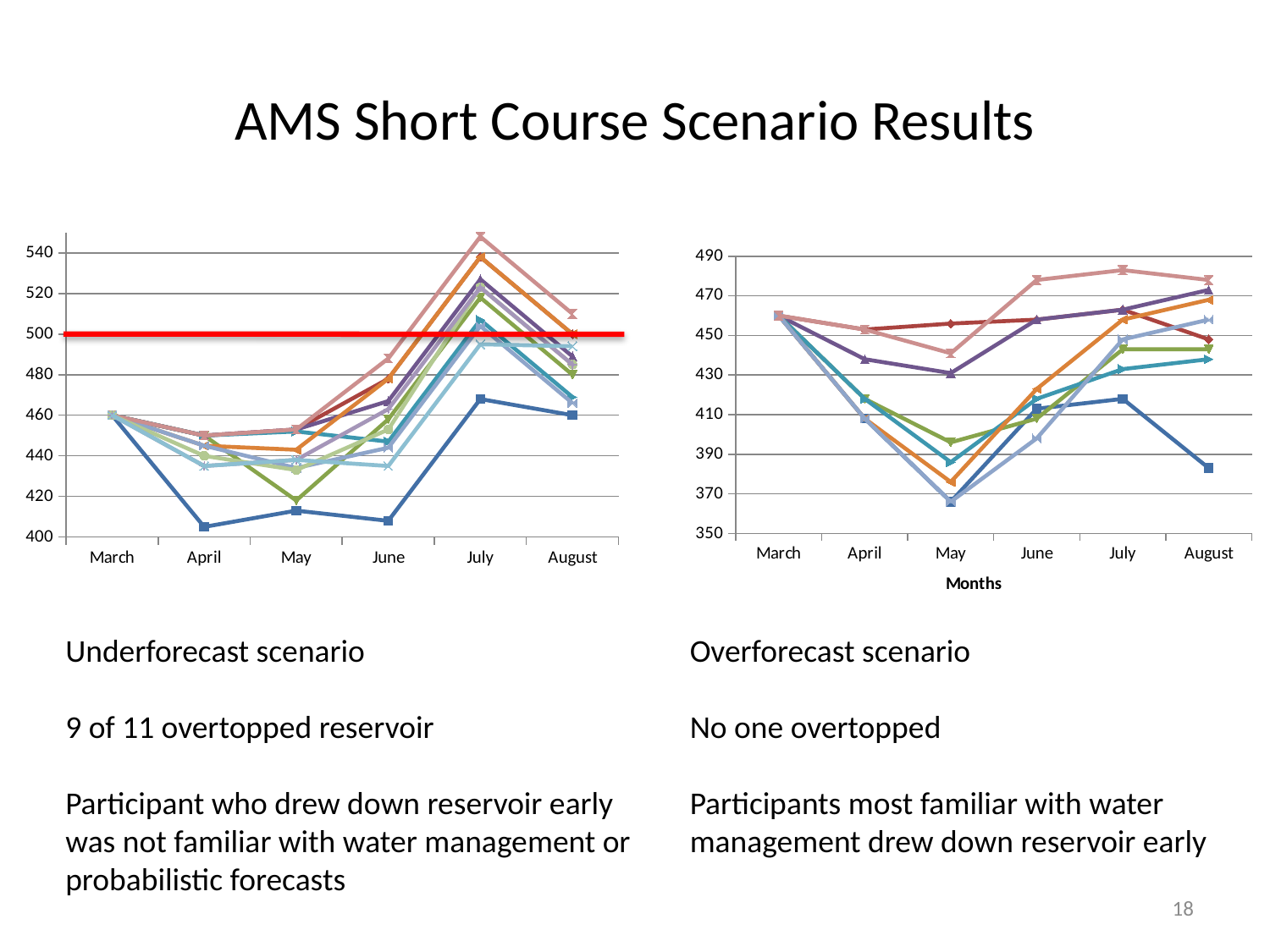
In the Underforecast scenario chart on the left, is the lowest value in April greater or less than 420? less How many months are shown on the x axis of the Overforecast scenario chart on the right? 6 In the Underforecast scenario chart on the left, in which month do the lines reach their highest values? July In the Overforecast scenario chart on the right, do the lines rise or fall from March to May? fall In the Overforecast scenario chart on the right, in which month does the lowest line reach its minimum? May In the Underforecast scenario chart on the left, what value does the red horizontal line mark? 500 In the Overforecast scenario chart on the right, is the highest value in July greater or less than 470? greater In the Underforecast scenario chart on the left, is the highest value in July greater or less than 540? greater In the Underforecast scenario chart on the left, do the lines rise or fall from June to July? rise What is the x-axis title of the Overforecast scenario chart on the right? Months What kind of chart is the Underforecast scenario chart on the left? line chart